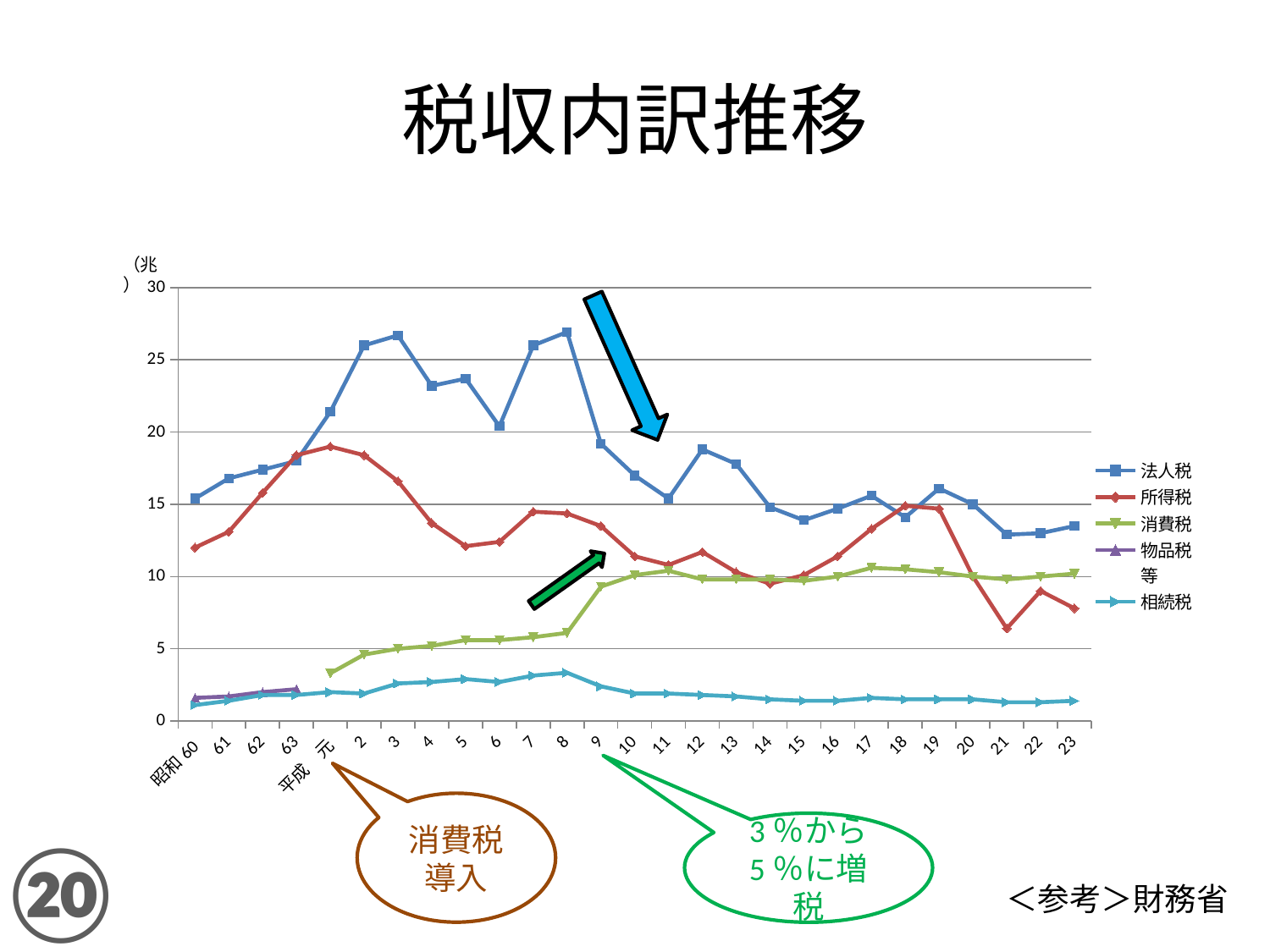
Does the 消費税 series rise or fall from 平成元 to 平成9? rise Is the value of 消費税 at 平成元 greater or less than 5? less How many points are plotted along the x axis for each series that spans the full range (from 昭和60 to 平成23)? 27 How many series does the legend list? 5 Which series has the highest value at 平成8? 法人税 At 平成3, which is larger: 法人税 or 所得税? 法人税 Is the value of 所得税 at 平成21 greater or less than 10? less At 平成21, which is larger: 消費税 or 所得税? 消費税 Is the value of 法人税 at 平成23 greater or less than 15? less What kind of chart is shown on the slide? line chart Which series has the lowest value at 平成23? 相続税